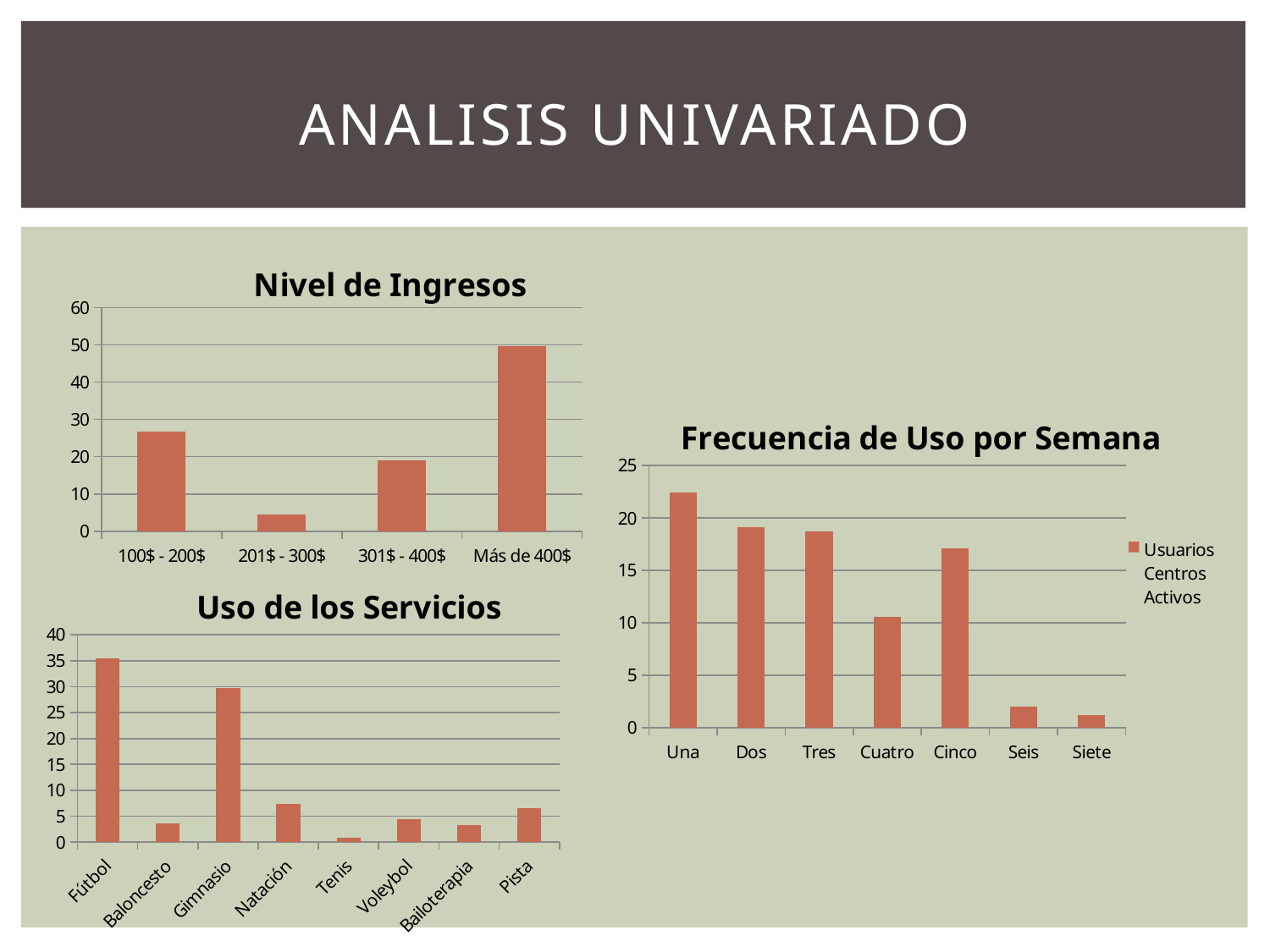
In the 'Uso de los Servicios' chart, which service has the highest value? Fútbol In the 'Frecuencia de Uso por Semana' chart, which frequency has the highest value? Una In the 'Nivel de Ingresos' chart, is the value for 'Más de 400$' greater or less than 40? greater In the 'Frecuencia de Uso por Semana' chart, how many series does the legend list? 1 In the 'Uso de los Servicios' chart, how many services are shown? 8 In the 'Uso de los Servicios' chart, which service has the lowest value? Tenis In the 'Frecuencia de Uso por Semana' chart, is the value for 'Cuatro' greater or less than 15? less In the 'Uso de los Servicios' chart, which is larger, Gimnasio or Natación? Gimnasio What type of chart is 'Frecuencia de Uso por Semana'? Bar chart In the 'Nivel de Ingresos' chart, how many income categories are shown? 4 In the 'Nivel de Ingresos' chart, which income category has the highest value? Más de 400$ In the 'Nivel de Ingresos' chart, which income category has the lowest value? 201$ - 300$